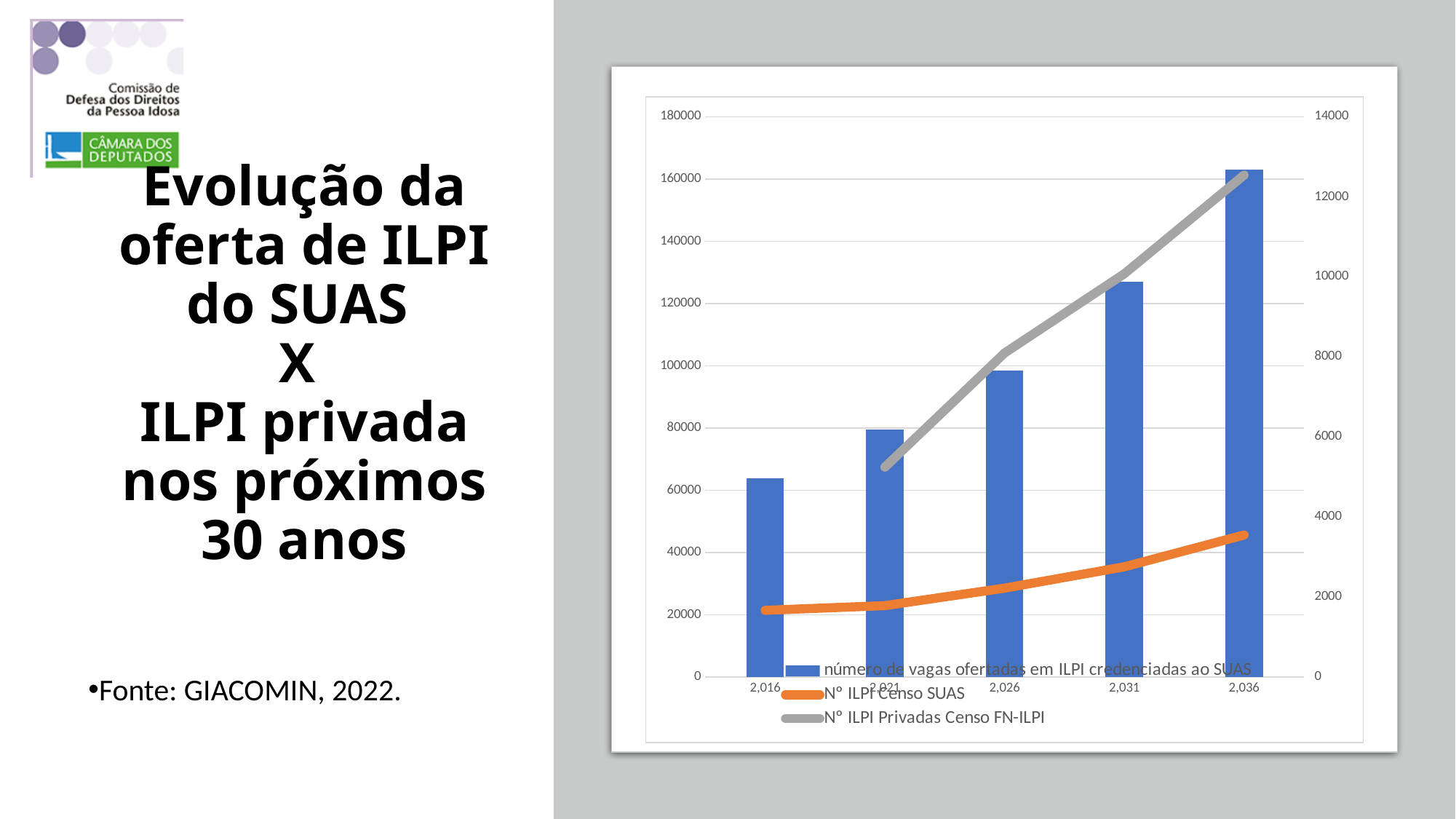
How many series does the chart's legend list? 3 Do the bars for 'número de vagas ofertadas em ILPI credenciadas ao SUAS' rise or fall from 2,016 to 2,036? rise Is the bar value for 2,036 greater or less than 160000 on the left axis? greater How many categories are shown on the x axis of the chart? 5 Which category has the shortest bar for 'número de vagas ofertadas em ILPI credenciadas ao SUAS'? 2,016 Does the 'N° ILPI Censo SUAS' line rise or fall from 2,016 to 2,036? rise Which series is drawn as a grey line? N° ILPI Privadas Censo FN-ILPI Is the bar value for 2,016 greater or less than 80000 on the left axis? less Which series is drawn as an orange line? N° ILPI Censo SUAS Which is larger, the bar for 2,021 or the bar for 2,031? 2,031 Which category has the tallest bar for 'número de vagas ofertadas em ILPI credenciadas ao SUAS'? 2,036